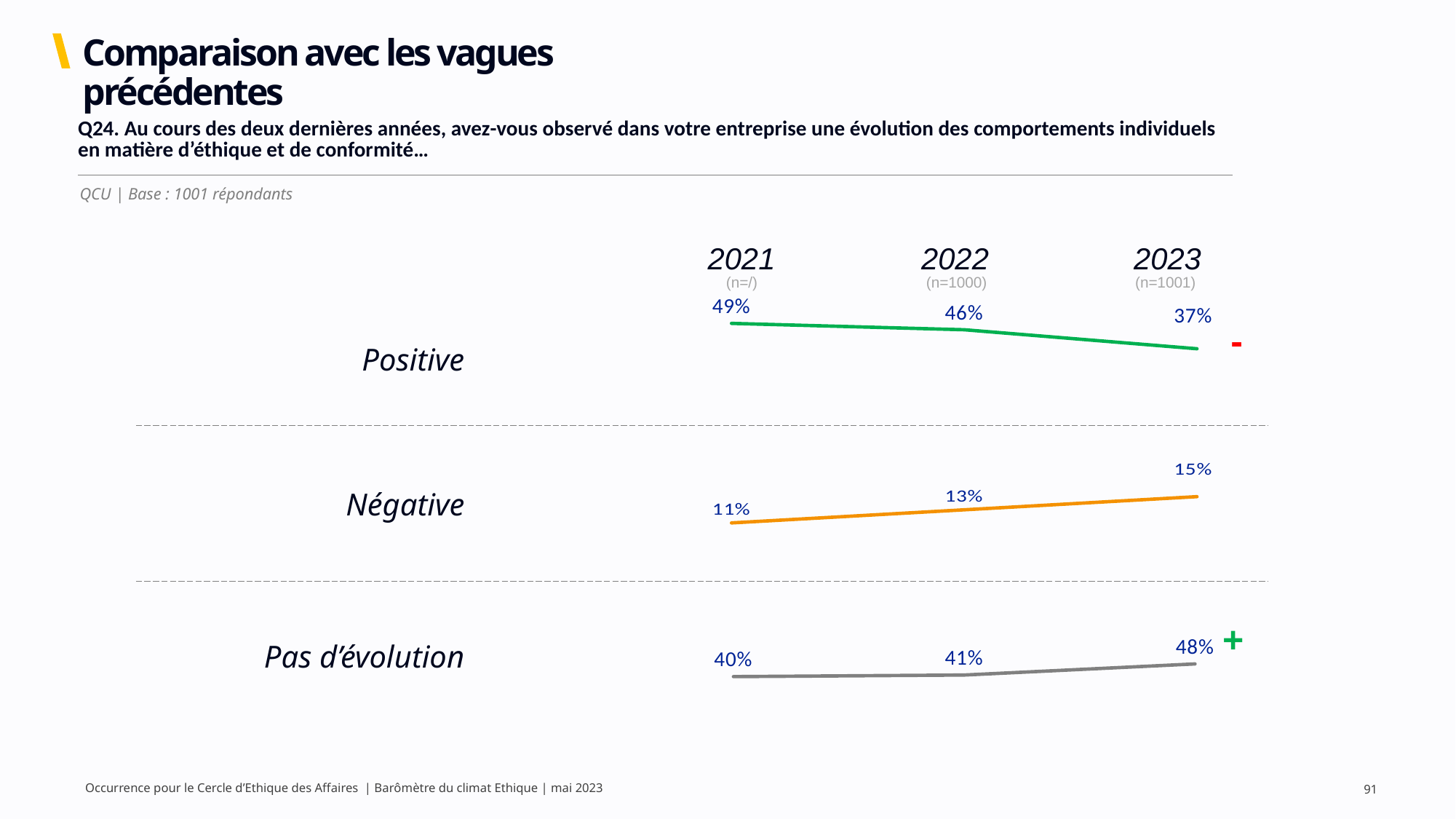
On the 'Positive' line chart, what is the difference between the 2021 and 2023 values? 12 percentage points On the 'Pas d'évolution' line chart, what is the difference between the 2023 and 2021 values? 8 percentage points In 2023, which is larger: the 'Positive' value or the 'Pas d'évolution' value? Pas d'évolution On the 'Négative' line chart, which year has the lowest value? 2021 On the 'Positive' line chart, what is the value for 2023? 37% On the 'Négative' line chart, what is the value for 2021? 11% On the 'Positive' line chart, do the values rise or fall from 2021 to 2023? fall On the 'Pas d'évolution' line chart, what is the value for 2022? 41% How many years (data points) are plotted on each line chart? 3 On the 'Négative' line chart, do the values rise or fall from 2021 to 2023? rise On the 'Positive' line chart, which year has the highest value? 2021 What kind of chart is used to show the 'Pas d'évolution' values? line chart